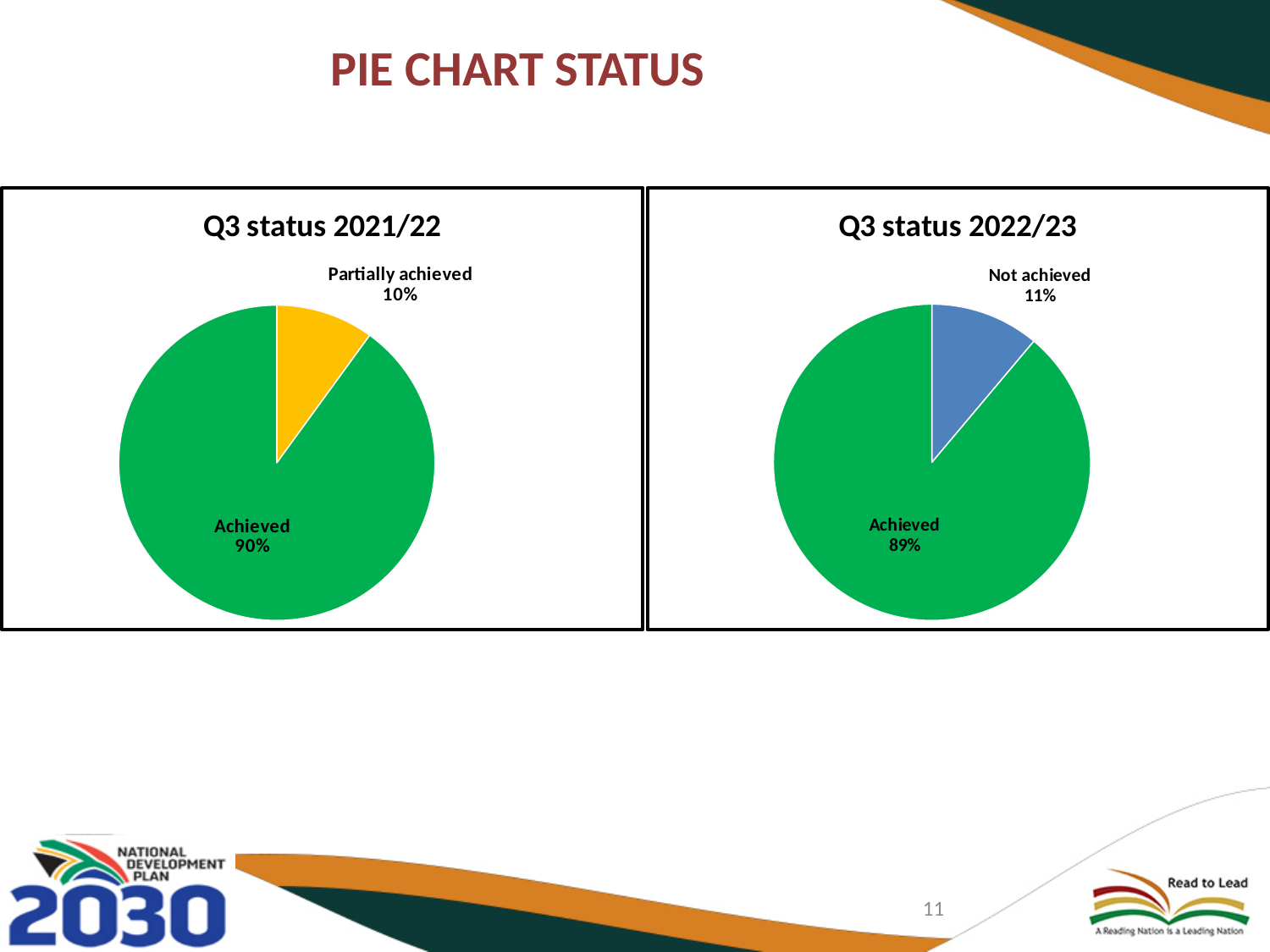
In the 'Q3 status 2021/22' chart, which category has the largest slice? Achieved What is the title of the chart on the right side of the slide? Q3 status 2022/23 In the 'Q3 status 2022/23' chart, what percentage is labelled as Not achieved? 11% In the 'Q3 status 2021/22' chart, what percentage is labelled as Achieved? 90% What type of chart is 'Q3 status 2021/22'? Pie chart In the 'Q3 status 2022/23' chart, which category has the smallest slice? Not achieved In the 'Q3 status 2021/22' chart, what percentage is labelled as Partially achieved? 10% What is the difference between the Achieved share in the 'Q3 status 2021/22' chart and the Achieved share in the 'Q3 status 2022/23' chart? 1% Is the Achieved share larger in the 'Q3 status 2021/22' chart or the 'Q3 status 2022/23' chart? Q3 status 2021/22 In the 'Q3 status 2022/23' chart, what percentage is labelled as Achieved? 89% In the 'Q3 status 2021/22' chart, what is the difference between the Achieved and Partially achieved shares? 80% How many slices does the 'Q3 status 2022/23' pie chart have? 2